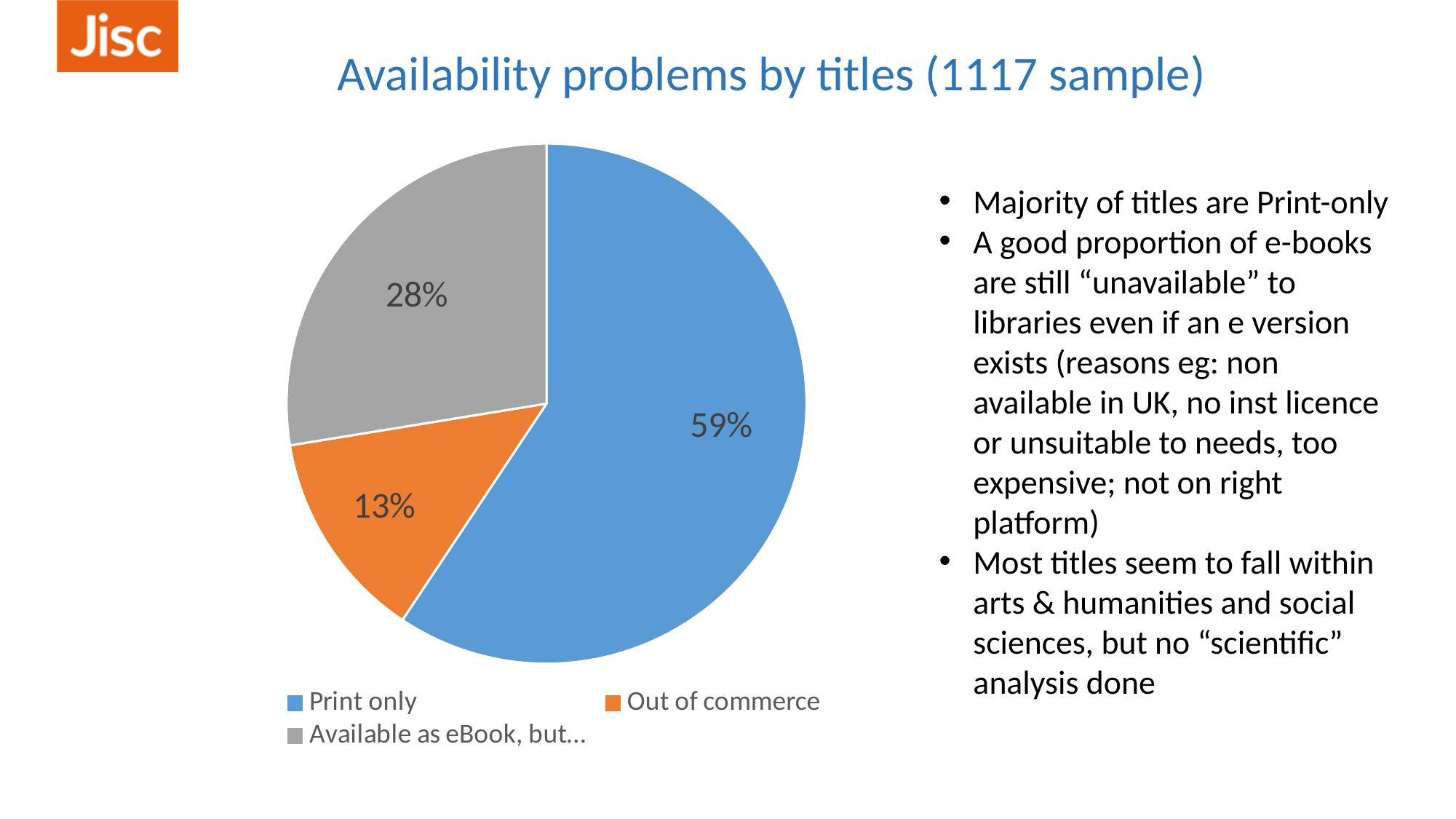
What is the title of the chart? Availability problems by titles (1117 sample) What share of titles is Available as eBook, but...? 28% Which category has the smallest slice of the pie? Out of commerce What is the difference in percentage points between Print only and Available as eBook, but...? 31 What share of titles is Out of commerce? 13% Which category has the largest slice of the pie? Print only What colour is the Print only slice? blue How many slices does the pie chart have? 3 What share of titles is Print only? 59% What kind of chart is shown on the slide? pie chart What is the difference in percentage points between Available as eBook, but... and Out of commerce? 15 Which is larger, the share for Out of commerce or the share for Available as eBook, but...? Available as eBook, but...